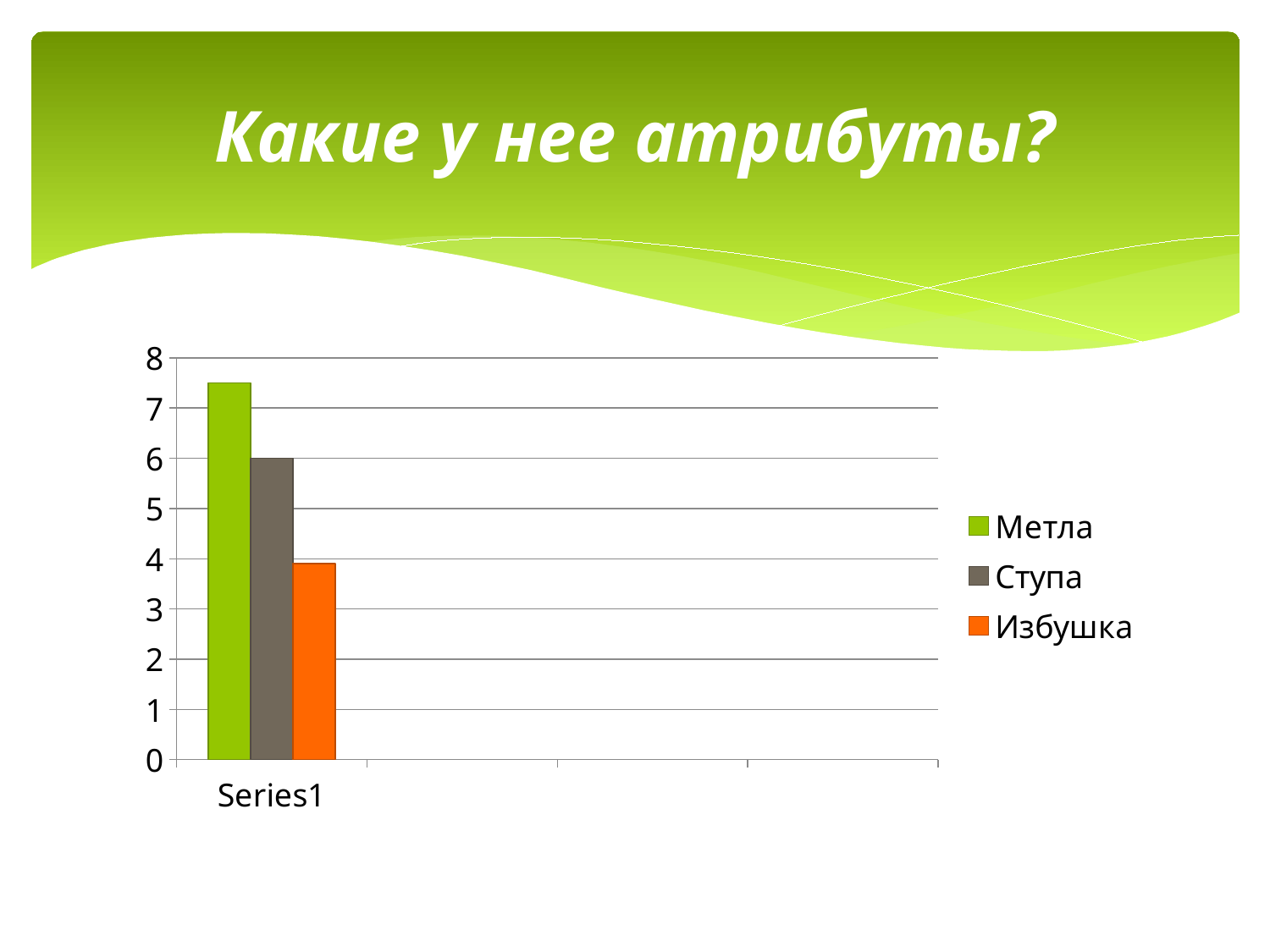
What kind of chart is shown on the slide? bar chart Which is larger, the value for Метла or the value for Ступа? Метла Is the value for Избушка greater or less than 3? greater Is the value for Избушка greater or less than 5? less Which is larger, the value for Ступа or the value for Избушка? Ступа What is the value for Ступа? 6 What colour is the bar for Избушка? orange Which series has the highest bar? Метла What is the category label shown on the x axis? Series1 Which series has the lowest bar? Избушка How many series does the legend list? 3 Is the value for Метла greater or less than 7? greater